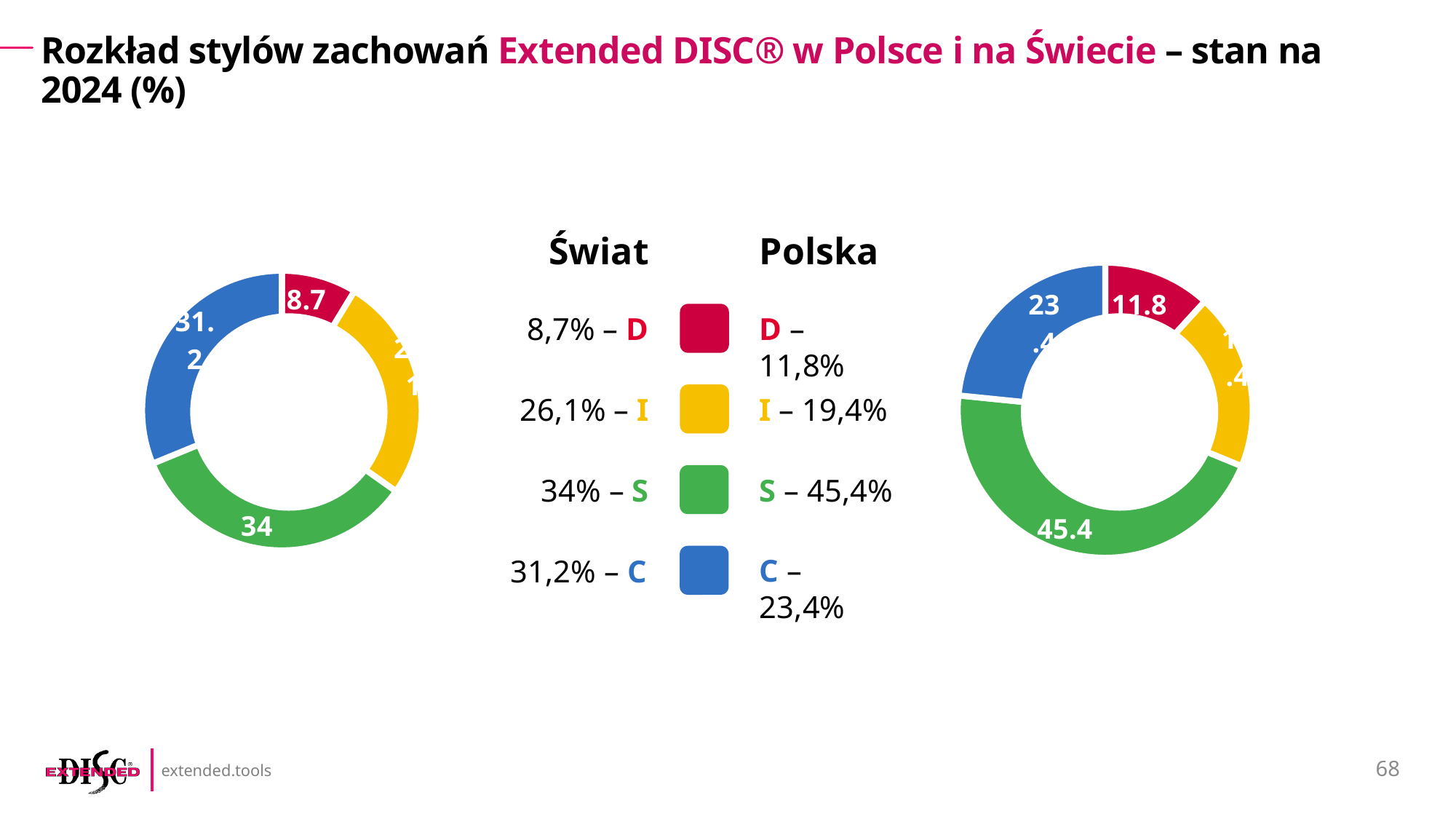
How many segments does each donut chart have? 4 On the Świat chart, what is the value for D? 8,7% On the Polska chart, which is larger, I or C? C On the Świat chart, which style has the largest share? S Which chart shows a larger share for C, Świat or Polska? Świat On the Świat chart, what is the value for C? 31,2% How much larger is the S share on the Polska chart than on the Świat chart? 11,4 percentage points On the Świat chart, which style has the smallest share? D On the Polska chart, what is the value for S? 45,4% What type of chart is used on this slide? Donut (pie) chart On the Polska chart, what is the value for I? 19,4% On the Polska chart, which style has the smallest share? D